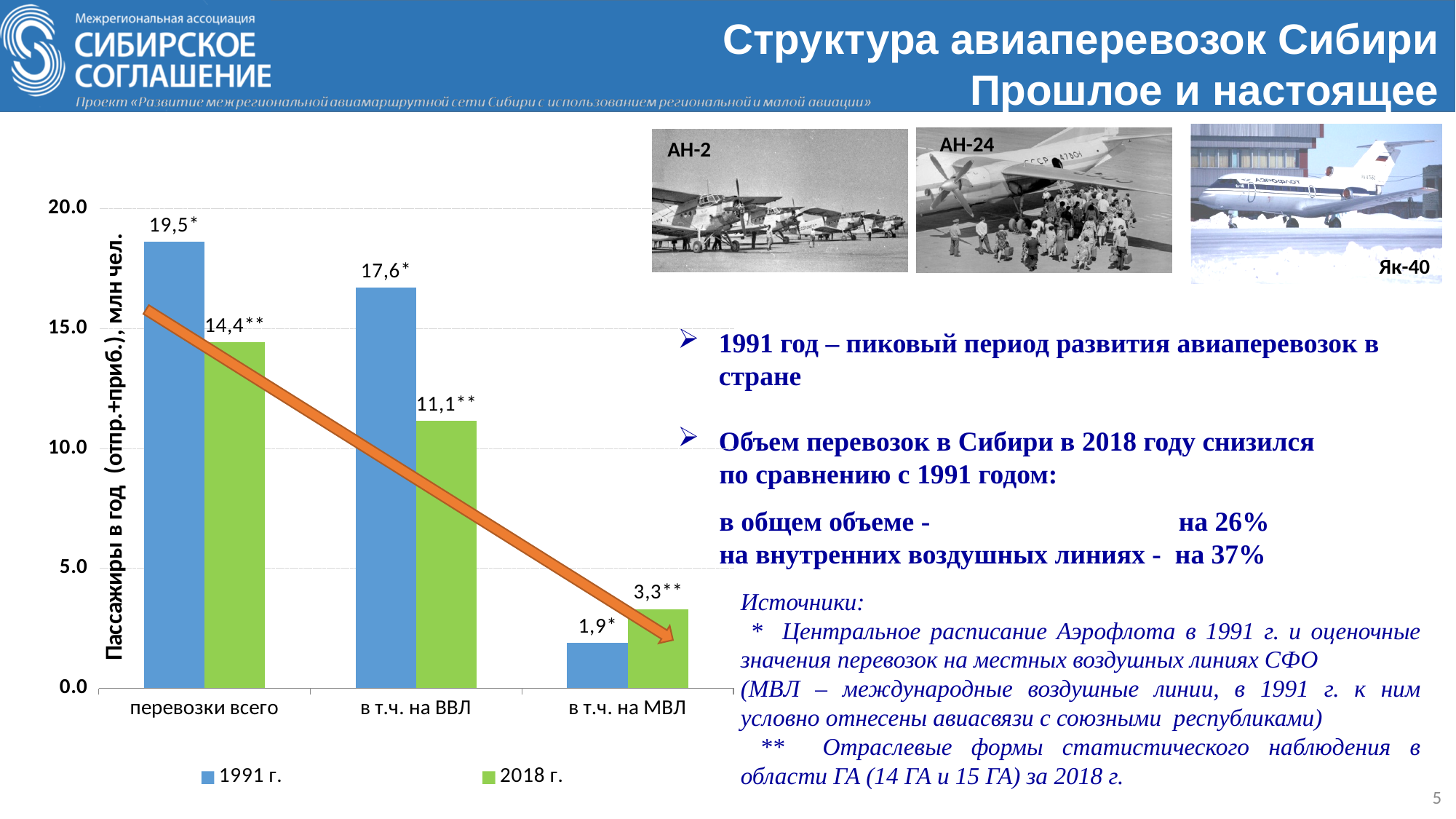
How many series does the legend list? 2 Which category has the lowest value in the 2018 г. series? в т.ч. на МВЛ What is the value for 'перевозки всего' in the 1991 г. series? 19,5 What type of chart is shown on the slide? bar chart For 'в т.ч. на МВЛ', which series has the larger value, 1991 г. or 2018 г.? 2018 г. How many categories are shown on the x axis? 3 What is the difference between the 1991 г. and 2018 г. values for 'в т.ч. на ВВЛ'? 6,5 What is the value for 'в т.ч. на ВВЛ' in the 2018 г. series? 11,1 Which category has the highest value in the 1991 г. series? перевозки всего What is the value for 'в т.ч. на МВЛ' in the 1991 г. series? 1,9 What is the label of the vertical axis? Пассажиры в год (отпр.+приб.), млн чел. What is the value for 'перевозки всего' in the 2018 г. series? 14,4